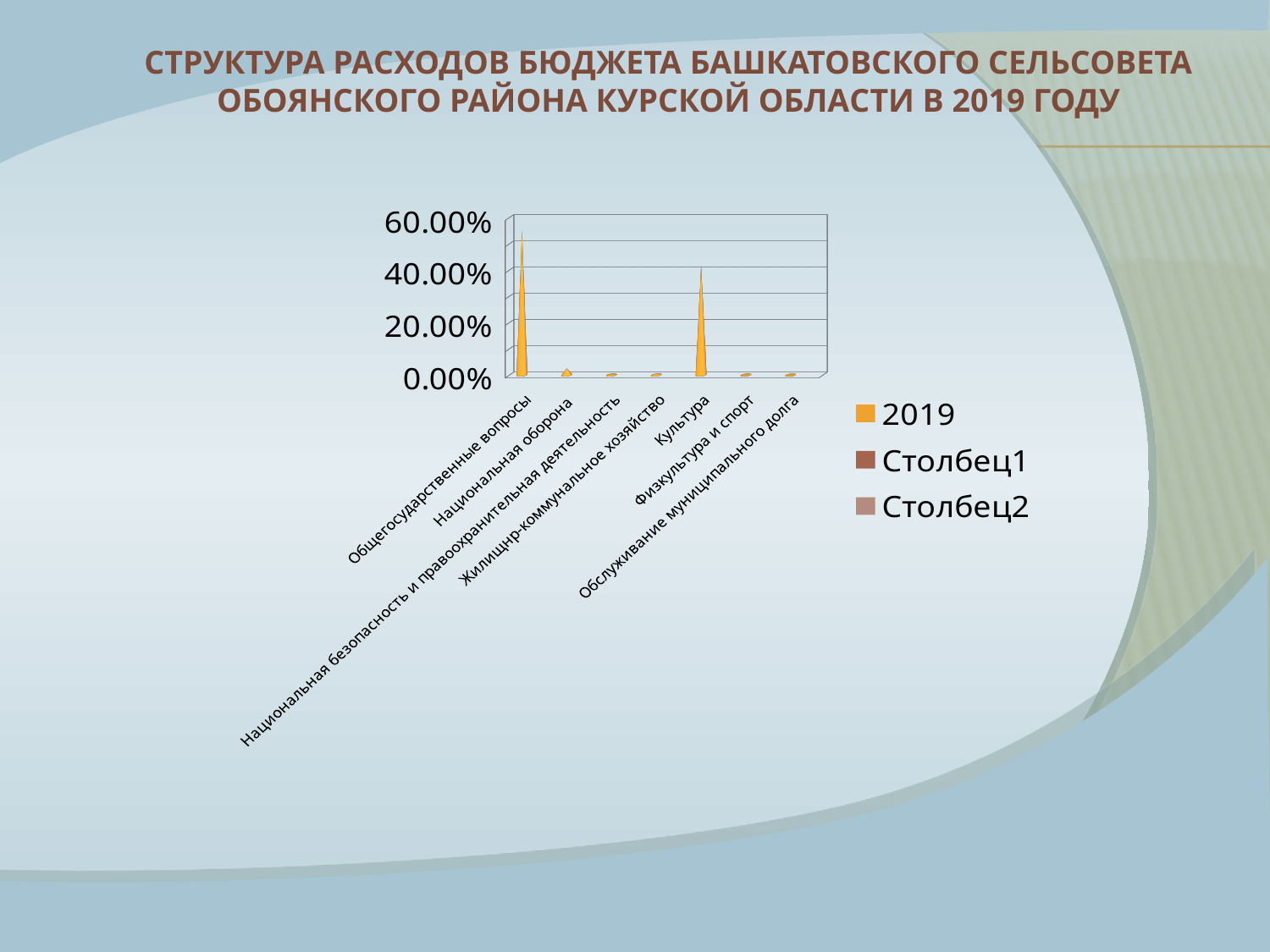
Which is larger, the value for Общегосударственные вопросы or the value for Культура? Общегосударственные вопросы What are the entries listed in the chart legend? 2019, Столбец1, Столбец2 Is the value for Общегосударственные вопросы greater or less than 40.00%? greater Which category has the highest value in the chart? Общегосударственные вопросы How many series does the legend list? 3 What is the highest value shown on the vertical axis of the chart? 60.00% How many categories are shown on the x axis of the chart? 7 Is the value for Национальная оборона greater or less than 20.00%? less What kind of chart is shown on the slide? bar chart Which is larger, the value for Культура or the value for Физкультура и спорт? Культура Is the value for Культура greater or less than 60.00%? less